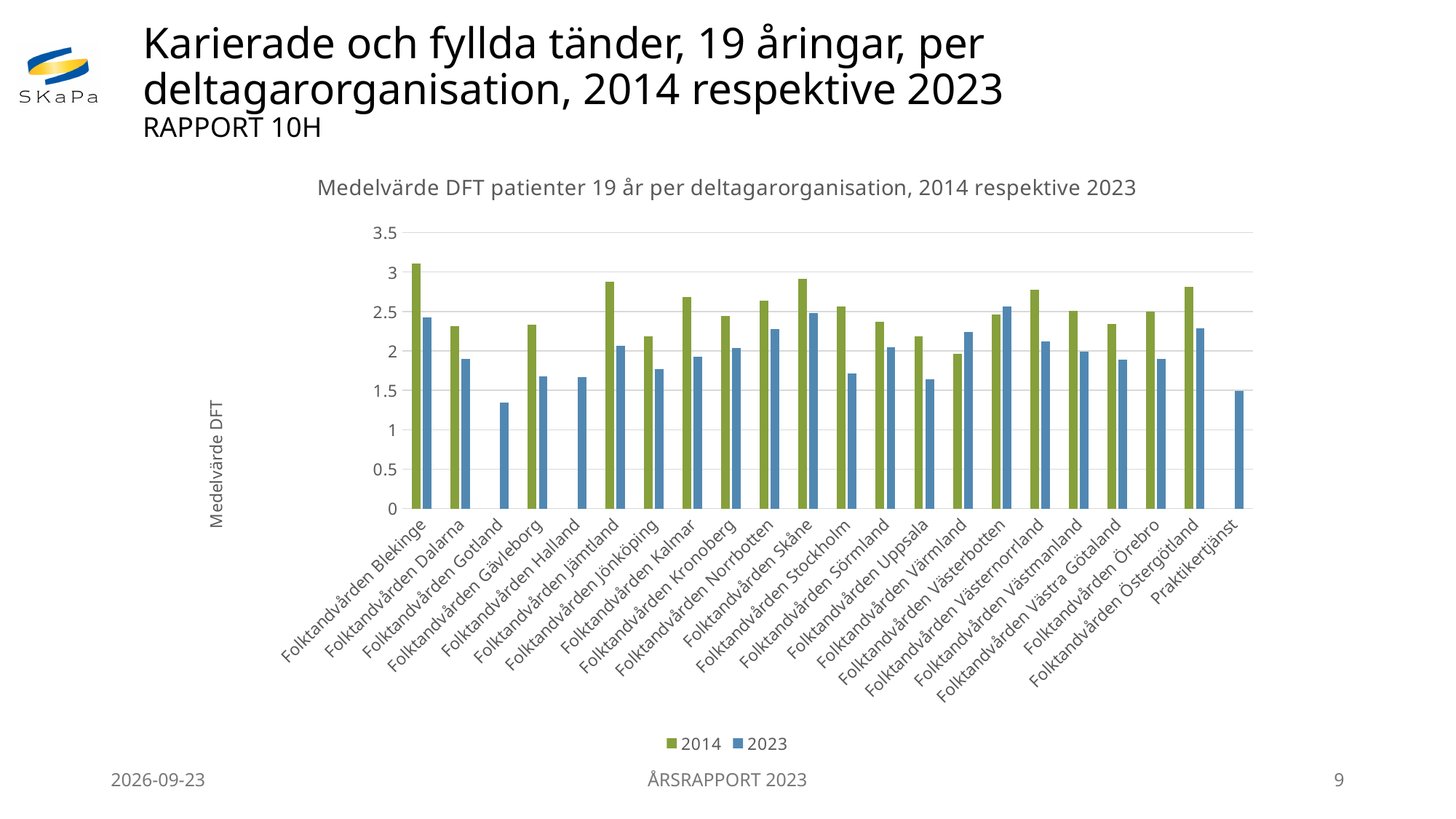
Which organisation has the highest value for 2014? Folktandvården Blekinge What is the label on the vertical axis of the chart? Medelvärde DFT What kind of chart is shown on the slide? bar chart How many series does the legend list? 2 Is the 2023 value for Folktandvården Gotland greater or less than 1.5? less For Folktandvården Värmland, which year has the larger value, 2014 or 2023? 2023 Is the 2014 value for Folktandvården Skåne greater or less than 2.5? greater For Folktandvården Blekinge, which year has the larger value, 2014 or 2023? 2014 How many organisations (categories) are shown on the x axis? 22 Is the 2023 value for Folktandvården Stockholm greater or less than 2? less Which organisation has the lowest value for 2023? Folktandvården Gotland